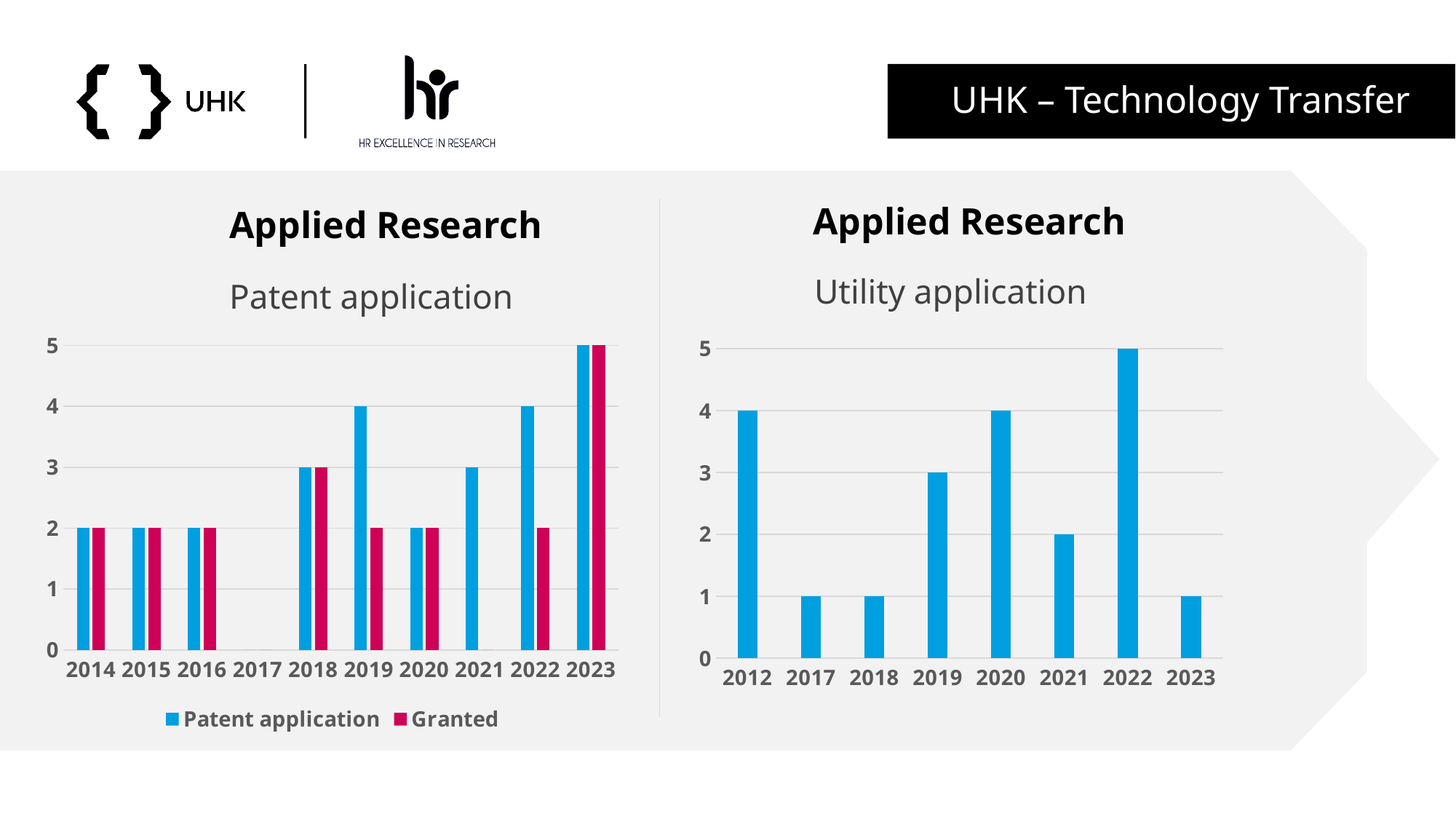
In the Utility application chart, what is the difference between the values for 2022 and 2023? 4 In the Patent application chart, what is the difference between patent applications and granted patents in 2021? 3 In the Patent application chart, how many patent applications were there in 2019? 4 In the Utility application chart, which is larger, the value for 2012 or the value for 2019? 2012 In the Patent application chart, how many years are shown on the x axis? 10 In the Patent application chart, which year has the highest number of patent applications? 2023 In the Utility application chart, what is the value for 2022? 5 In the Patent application chart, how many series does the legend list? 2 In the Patent application chart, how many patents were granted in 2022? 2 In the Utility application chart, which year has the highest value? 2022 In the Patent application chart, which colour represents the Granted series? Red What type of chart is the Utility application chart? Bar chart